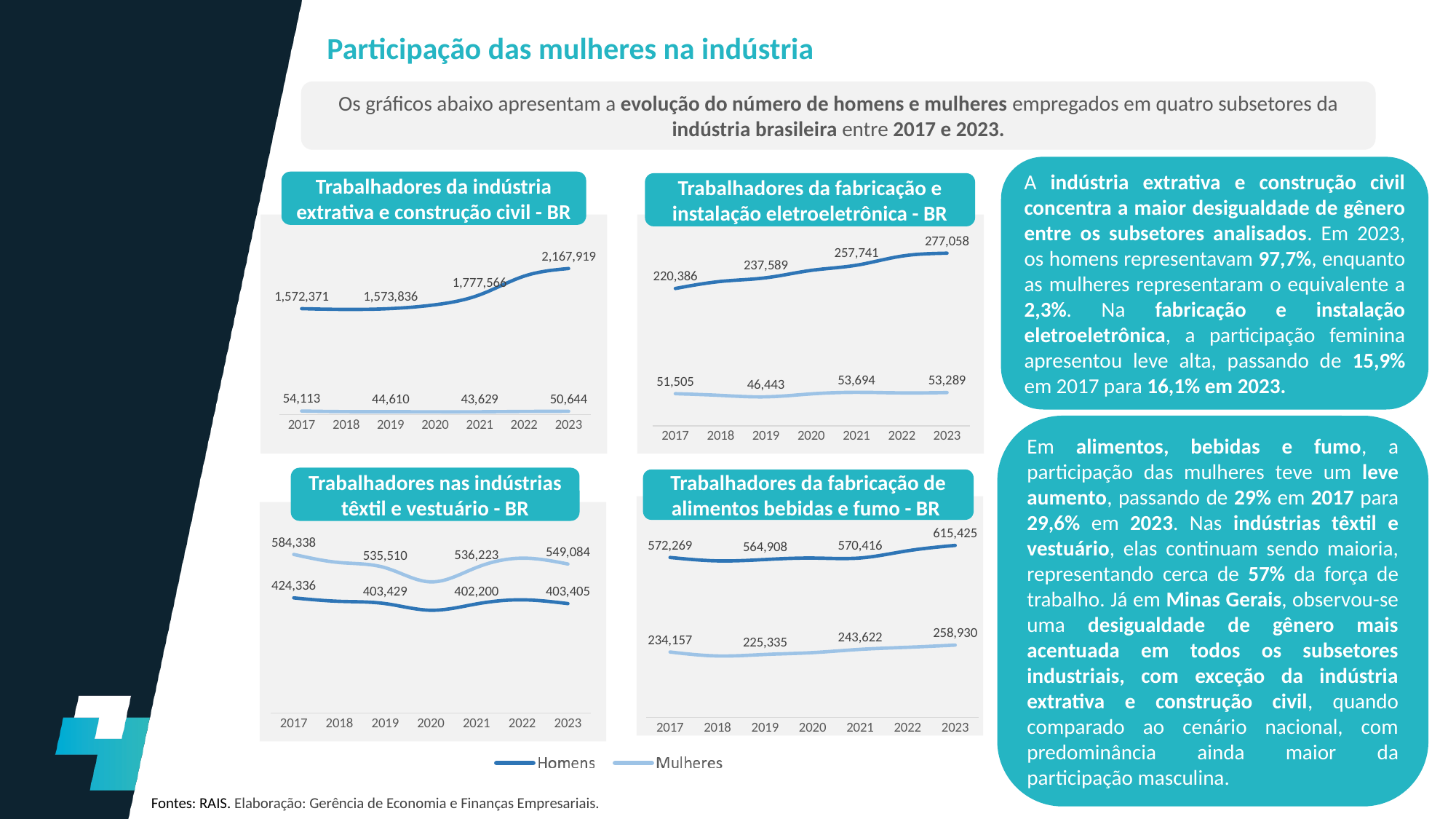
In the chart 'Trabalhadores da fabricação e instalação eletroeletrônica - BR', what is the value for Mulheres in 2017? 51,505 In the chart 'Trabalhadores da fabricação de alimentos bebidas e fumo - BR', what is the value for Mulheres in 2023? 258,930 In the chart 'Trabalhadores da fabricação e instalação eletroeletrônica - BR', what is the difference between the Homens values in 2023 and 2017? 56,672 In the chart 'Trabalhadores nas indústrias têxtil e vestuário - BR', what is the value for Homens in 2021? 402,200 In the chart 'Trabalhadores nas indústrias têxtil e vestuário - BR', in which labelled year is the Mulheres value highest? 2017 How many series does the shared legend at the bottom of the slide list? 2 In the chart 'Trabalhadores nas indústrias têxtil e vestuário - BR', which series has the larger value in 2023, Homens or Mulheres? Mulheres In the chart 'Trabalhadores da fabricação e instalação eletroeletrônica - BR', does the Homens series rise or fall from 2017 to 2023? Rise What kind of chart is 'Trabalhadores da indústria extrativa e construção civil - BR'? Line chart In the chart 'Trabalhadores da indústria extrativa e construção civil - BR', what is the value for Homens in 2023? 2,167,919 In the chart 'Trabalhadores da indústria extrativa e construção civil - BR', in which labelled year is the Mulheres value lowest? 2021 How many years are shown on the x axis of the chart 'Trabalhadores da fabricação de alimentos bebidas e fumo - BR'? 7